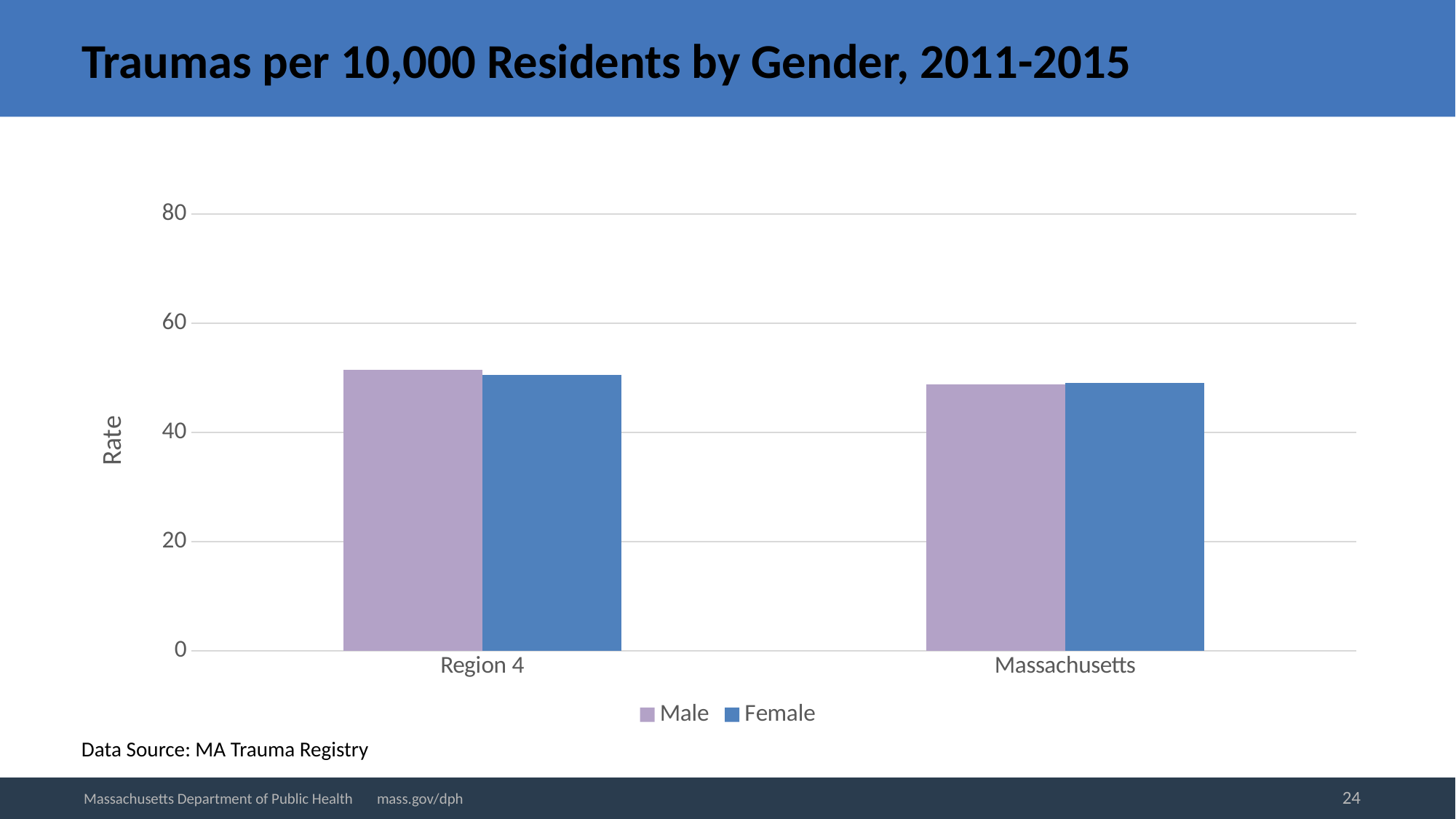
Is the Male value for Region 4 greater or less than 40? greater How many series does the legend list? 2 Is the Female value for Region 4 greater or less than 60? less Is the Female value for Massachusetts greater or less than 40? greater How many categories are shown on the x axis? 2 Which is larger, the Male value for Region 4 or the Male value for Massachusetts? Region 4 What is the title of the chart? Traumas per 10,000 Residents by Gender, 2011-2015 What kind of chart is shown on the slide? bar chart What is the label on the y axis? Rate